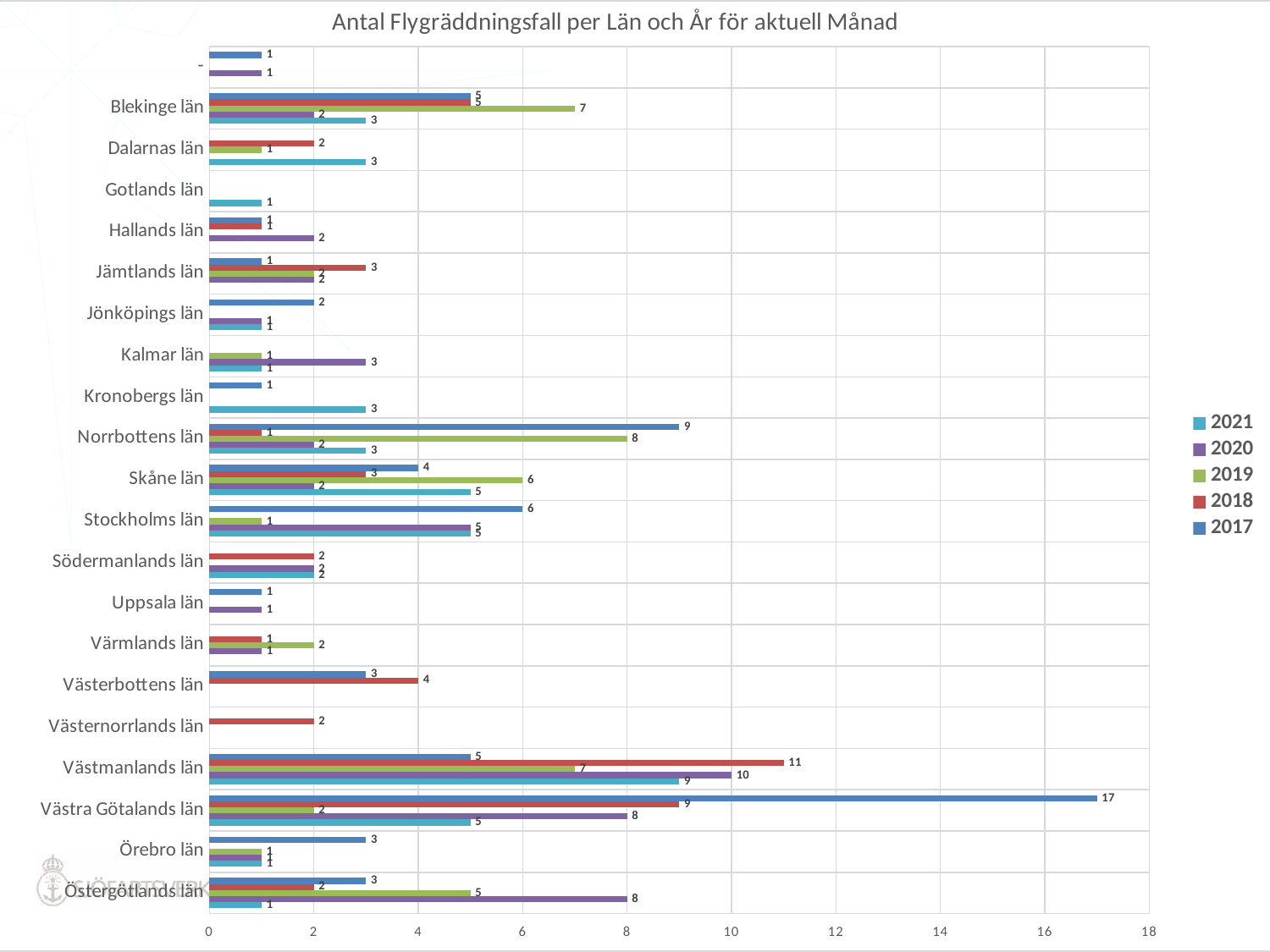
Is the 2018 value for Västmanlands län greater or less than 10? greater What is the value for Skåne län in 2021? 5 Which is larger: the 2020 value for Östergötlands län or the 2020 value for Västra Götalands län? They are equal (8) What is the value for Norrbottens län in 2019? 8 What type of chart is shown on the slide? bar chart Which county has the highest value in 2017? Västra Götalands län How many series does the legend list? 5 What is the value for Västmanlands län in 2018? 11 What is the value for Västra Götalands län in 2017? 17 What is the title of the chart? Antal Flygräddningsfall per Län och År för aktuell Månad Which county has the highest value in 2018? Västmanlands län What is the difference between the 2017 value for Västra Götalands län and the 2018 value for Västmanlands län? 6